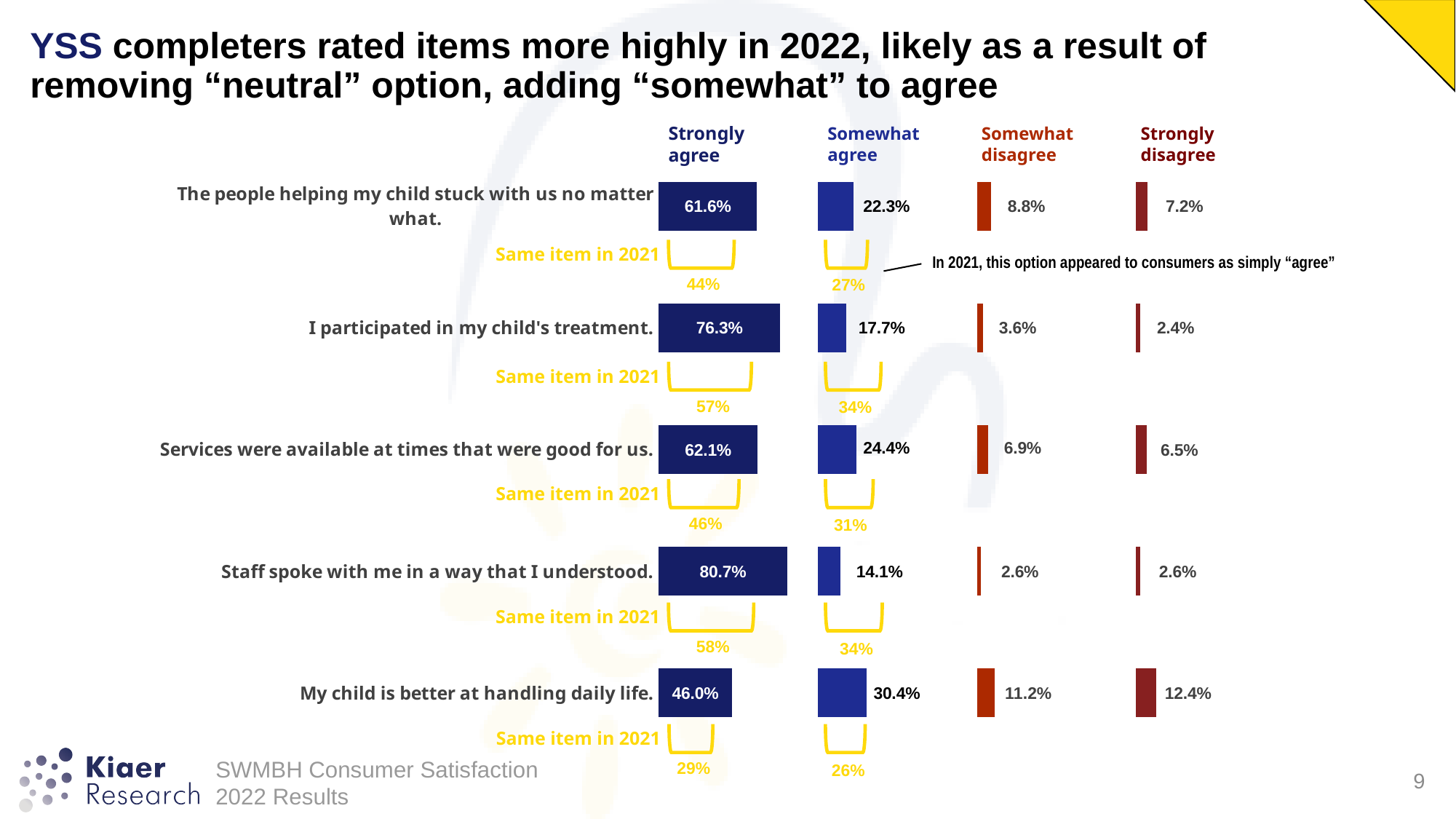
Which item has the lowest "Strongly agree" percentage? My child is better at handling daily life. Which item has the highest "Strongly agree" percentage? Staff spoke with me in a way that I understood. What is the "Strongly disagree" value for "The people helping my child stuck with us no matter what"? 7.2% Which item has the highest "Strongly disagree" percentage? My child is better at handling daily life. How many survey items are shown in the chart? 5 What percentage of YSS completers strongly agreed with "Staff spoke with me in a way that I understood"? 80.7% What is the difference between the 2022 and 2021 "Strongly agree" values for "Services were available at times that were good for us"? 16.1% Which is larger for "My child is better at handling daily life": the "Somewhat disagree" value or the "Strongly disagree" value? Strongly disagree What is the "Somewhat agree" value for "My child is better at handling daily life"? 30.4% What type of chart is shown on the slide? Bar chart How many response categories are shown as column headings in the chart? 4 What was the 2021 "Strongly agree" value for "I participated in my child's treatment"? 57%